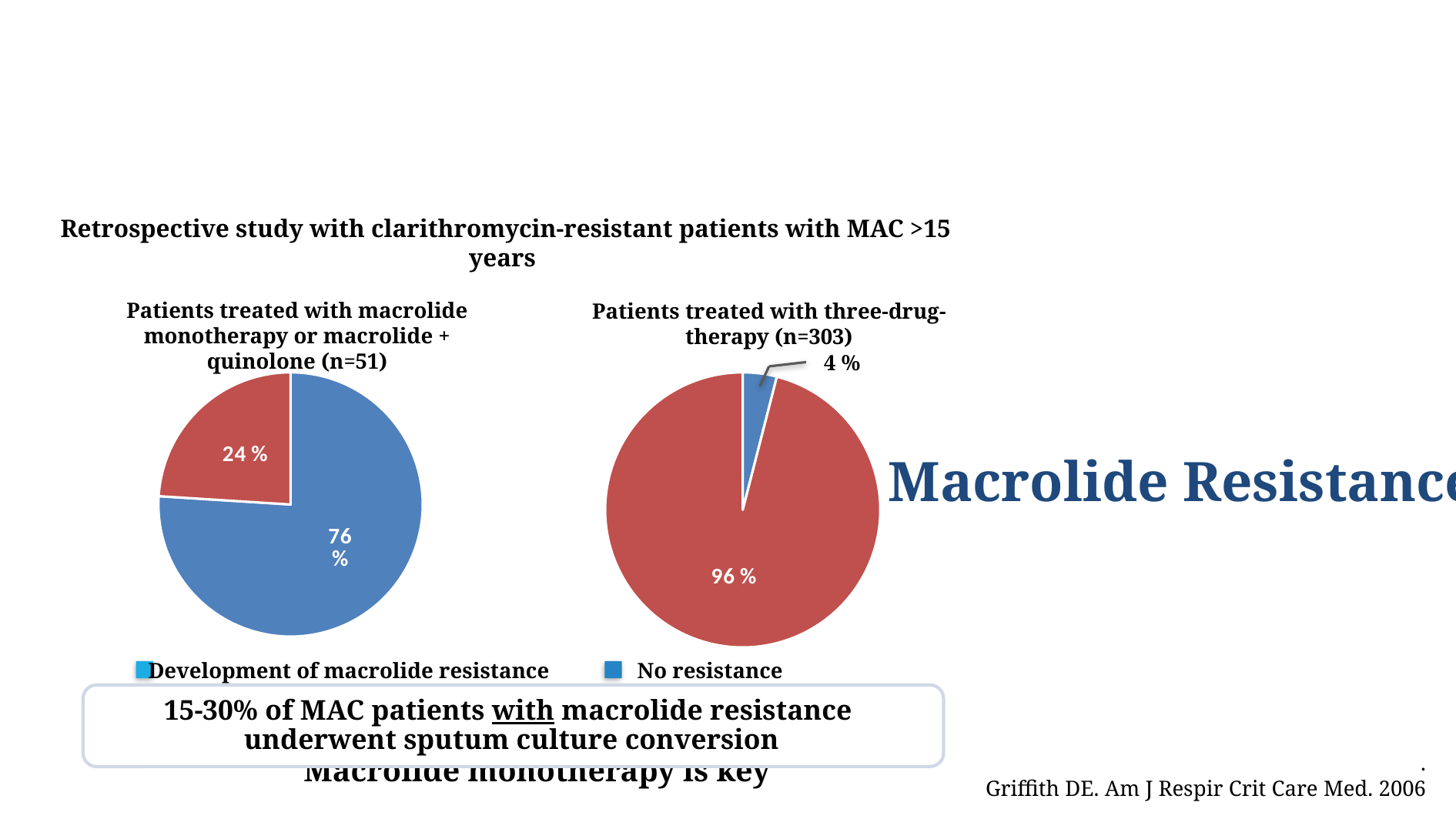
What are the two entries in the legend below the pie charts? Development of macrolide resistance; No resistance In the left pie chart (macrolide monotherapy or macrolide + quinolone), what is the difference in percentage points between the two slices? 52 percentage points Which is larger: the red slice in the left pie chart or the red slice in the right pie chart? The red slice in the right pie chart In the right pie chart (three-drug therapy), what is the difference in percentage points between the two slices? 92 percentage points What is the sample size (n) given in the title of the right pie chart (three-drug therapy)? 303 How many slices does each pie chart have? 2 In the left pie chart (macrolide monotherapy or macrolide + quinolone), what percentage is shown for the blue slice? 76 % What kind of charts are shown on the slide? Pie charts In the right pie chart (three-drug therapy), what percentage is shown for the small blue slice? 4 % In the right pie chart (three-drug therapy), what percentage is shown for the red slice? 96 % In the left pie chart (macrolide monotherapy or macrolide + quinolone), what percentage is shown for the red slice? 24 % How many entries does the legend below the pie charts list? 2